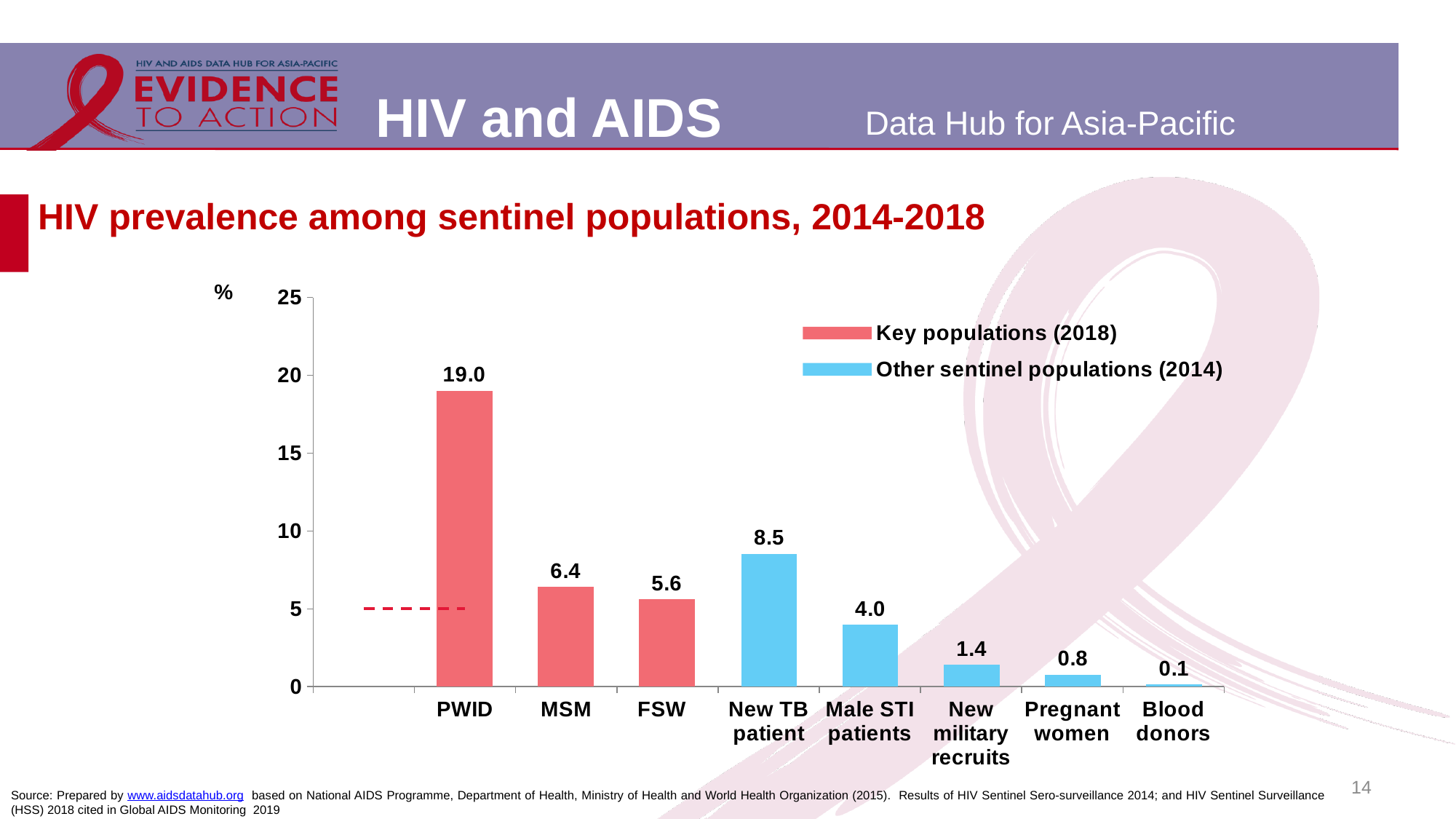
What is the HIV prevalence among PWID? 19.0 What is the HIV prevalence among pregnant women? 0.8 What is the HIV prevalence among new TB patients? 8.5 What is the difference in HIV prevalence between PWID and new TB patients? 10.5 What kind of chart is shown? Bar chart Which legend entry is shown in blue? Other sentinel populations (2014) Which has a higher HIV prevalence, male STI patients or new military recruits? Male STI patients What is the difference in HIV prevalence between MSM and FSW? 0.8 How many series does the legend list? 2 How many populations are shown on the chart? 8 Which population has the lowest HIV prevalence? Blood donors Which population has the highest HIV prevalence? PWID